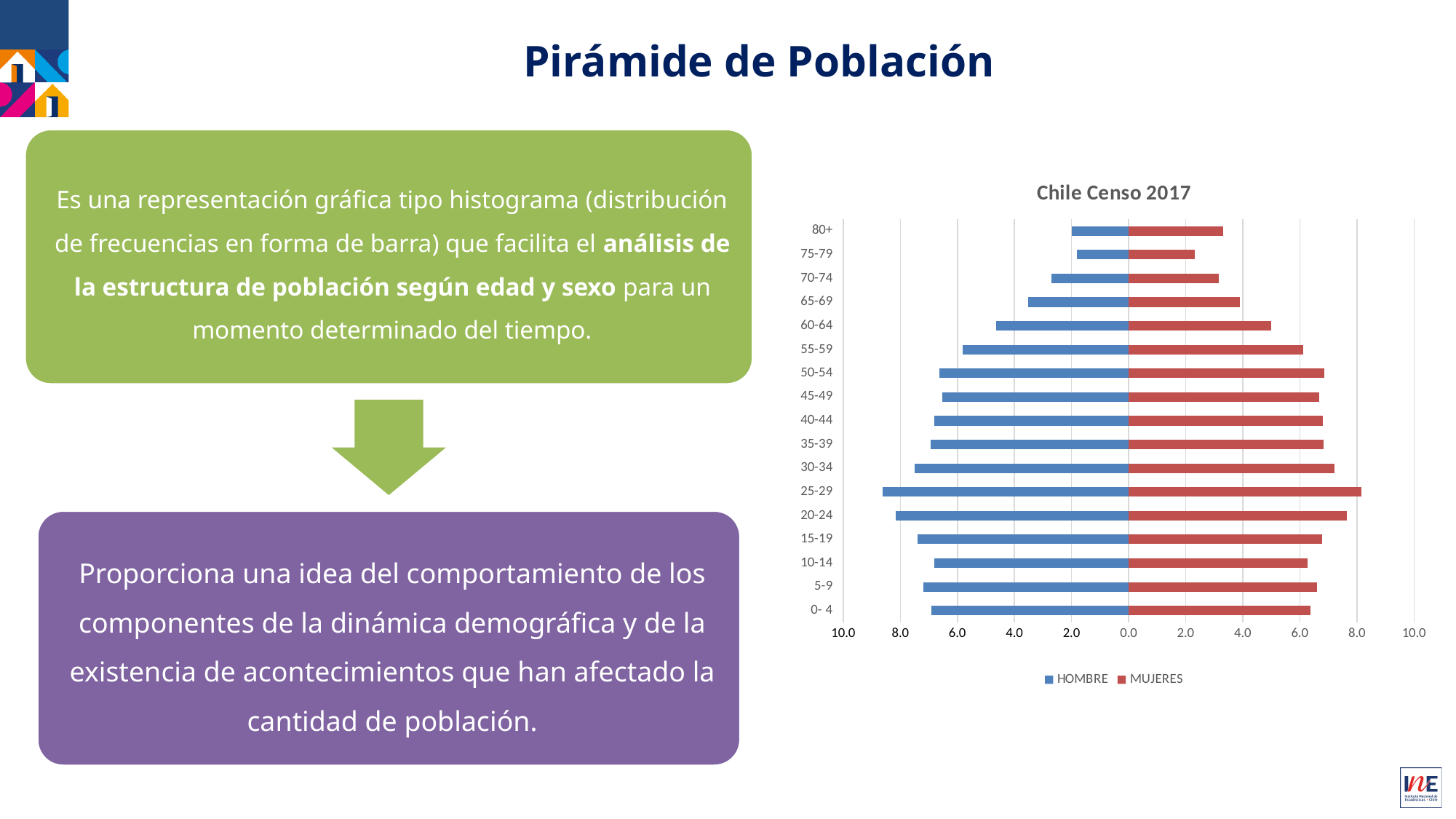
Which age group has the highest value for HOMBRE? 25-29 Which colour represents the HOMBRE series in the chart? blue Is the HOMBRE value for the 60-64 age group greater or less than 6.0? less Which age group has the lowest value for MUJERES? 75-79 How many age groups are shown on the chart? 17 What is the title of the chart? Chile Censo 2017 Which age group has the highest value for MUJERES? 25-29 For the 80+ age group, which series has the larger value, HOMBRE or MUJERES? MUJERES Is the HOMBRE value for the 25-29 age group greater or less than 8.0? greater Is the MUJERES value for the 80+ age group greater or less than 2.0? greater How many series does the chart legend list? 2 What kind of chart is shown on the slide? bar chart